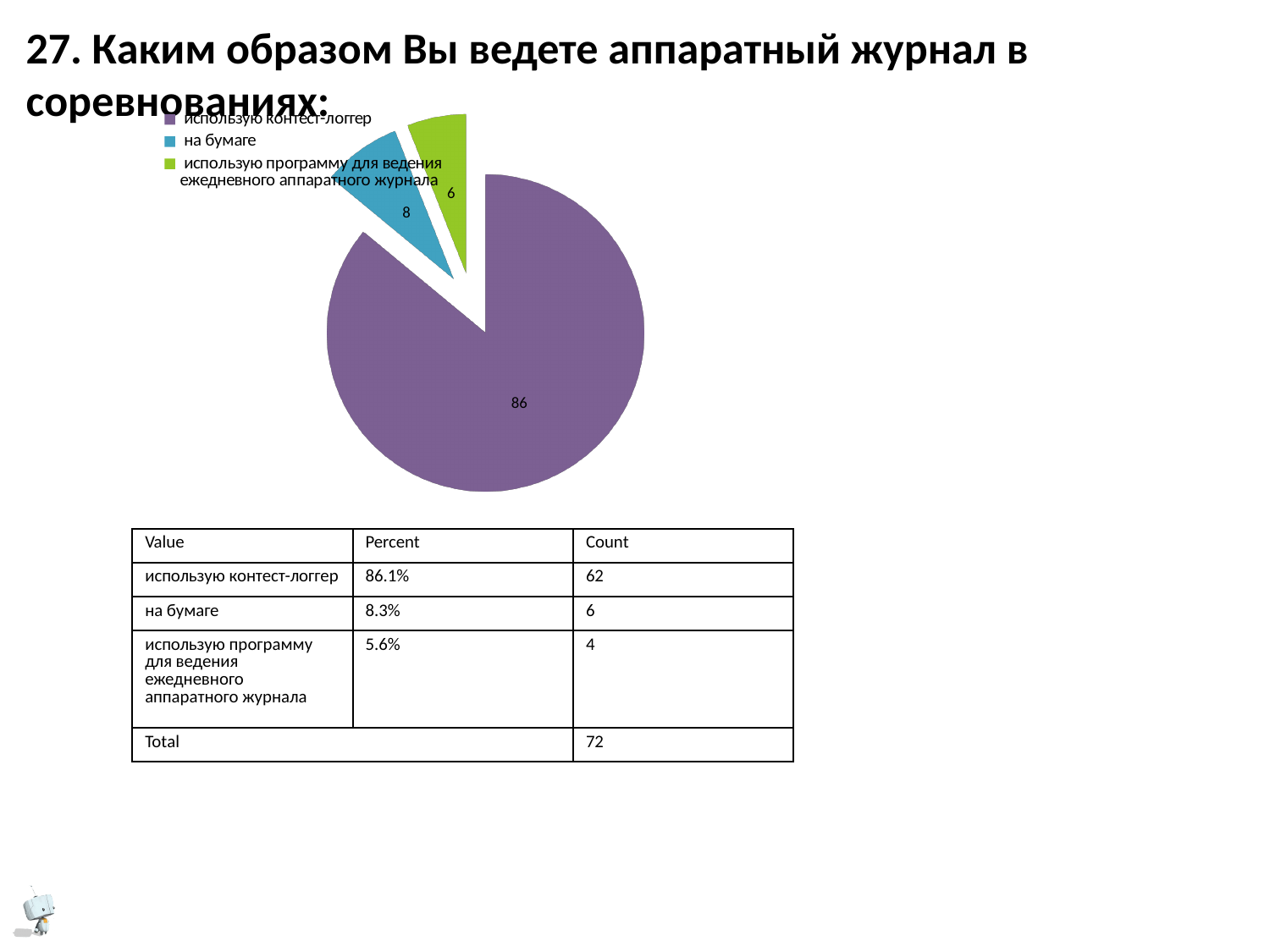
What is the difference between the printed values for "использую контест-логгер" and "на бумаге" in the pie chart? 78 What value is printed on the pie slice for "на бумаге"? 8 What kind of chart is shown on the slide? pie chart Which category has the smallest slice in the pie chart? использую программу для ведения ежедневного аппаратного журнала What colour is the slice for "использую контест-логгер" in the pie chart? purple Which category has the largest slice in the pie chart? использую контест-логгер Which slice is larger in the pie chart: "на бумаге" or "использую программу для ведения ежедневного аппаратного журнала"? на бумаге What colour is the slice for "на бумаге" in the pie chart? teal How many slices does the pie chart have? 3 What value is printed on the pie slice for "использую программу для ведения ежедневного аппаратного журнала"? 6 What value is printed on the pie slice for "использую контест-логгер"? 86 How many entries does the legend of the pie chart list? 3